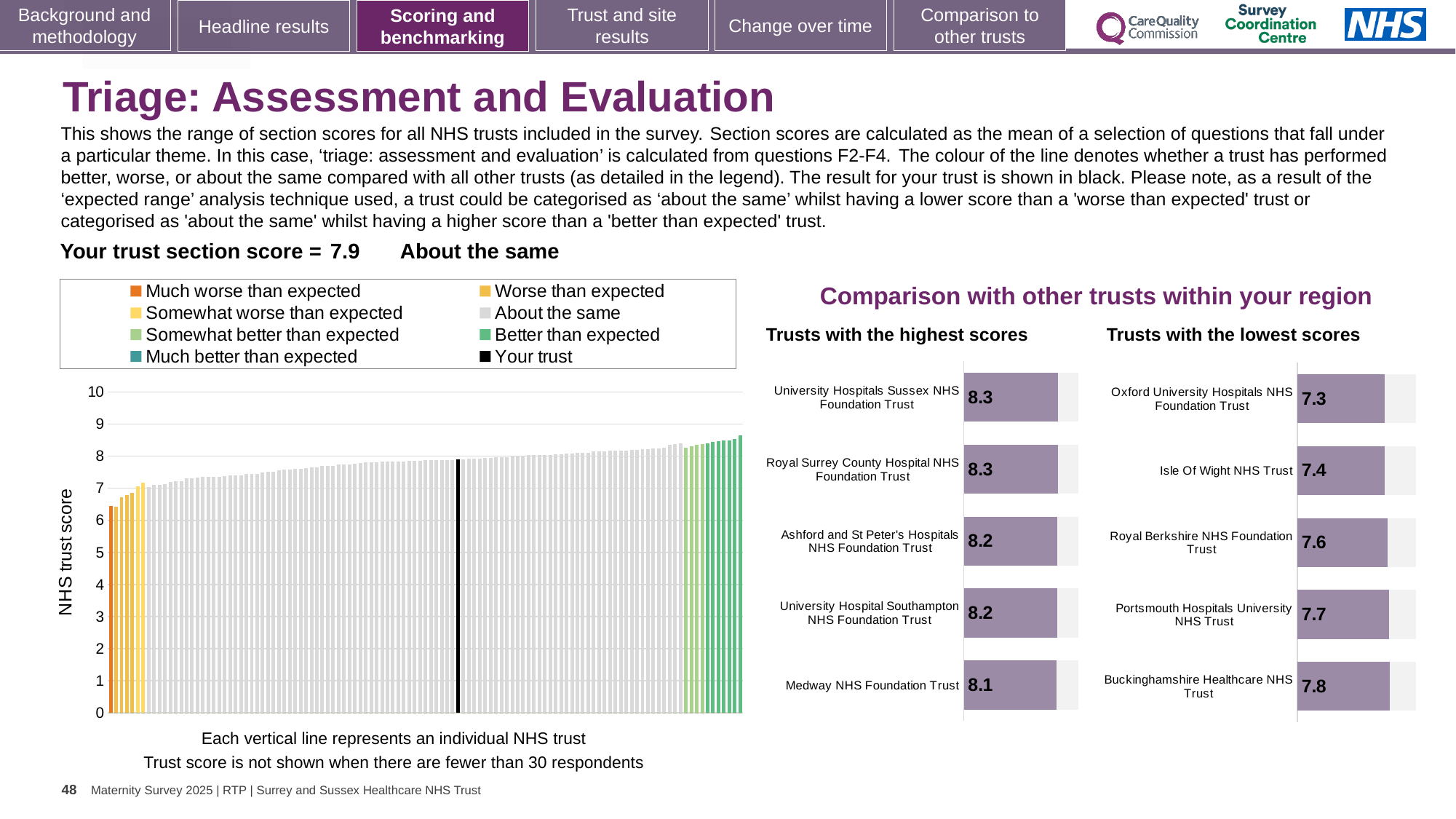
In the 'Trusts with the highest scores' chart, which trust has the lowest score? Medway NHS Foundation Trust In the 'NHS trust score' chart, is the value of the leftmost (lowest) bar greater or less than 7? less How many trusts are shown in the 'Trusts with the highest scores' chart? 5 In the 'Trusts with the lowest scores' chart, which trust has the lowest score? Oxford University Hospitals NHS Foundation Trust What kind of chart is the large 'NHS trust score' chart on the left? Bar chart How many entries does the legend of the 'NHS trust score' chart list? 8 In the 'Trusts with the lowest scores' chart, which has the higher score: Royal Berkshire NHS Foundation Trust or Isle Of Wight NHS Trust? Royal Berkshire NHS Foundation Trust In the 'Trusts with the lowest scores' chart, what is the score for Portsmouth Hospitals University NHS Trust? 7.7 In the 'Trusts with the lowest scores' chart, what is the score for Oxford University Hospitals NHS Foundation Trust? 7.3 In the 'NHS trust score' chart, do the values rise or fall from left to right? Rise In the 'Trusts with the highest scores' chart, what is the score for Medway NHS Foundation Trust? 8.1 In the 'Trusts with the lowest scores' chart, what is the difference between the scores of Buckinghamshire Healthcare NHS Trust and Oxford University Hospitals NHS Foundation Trust? 0.5